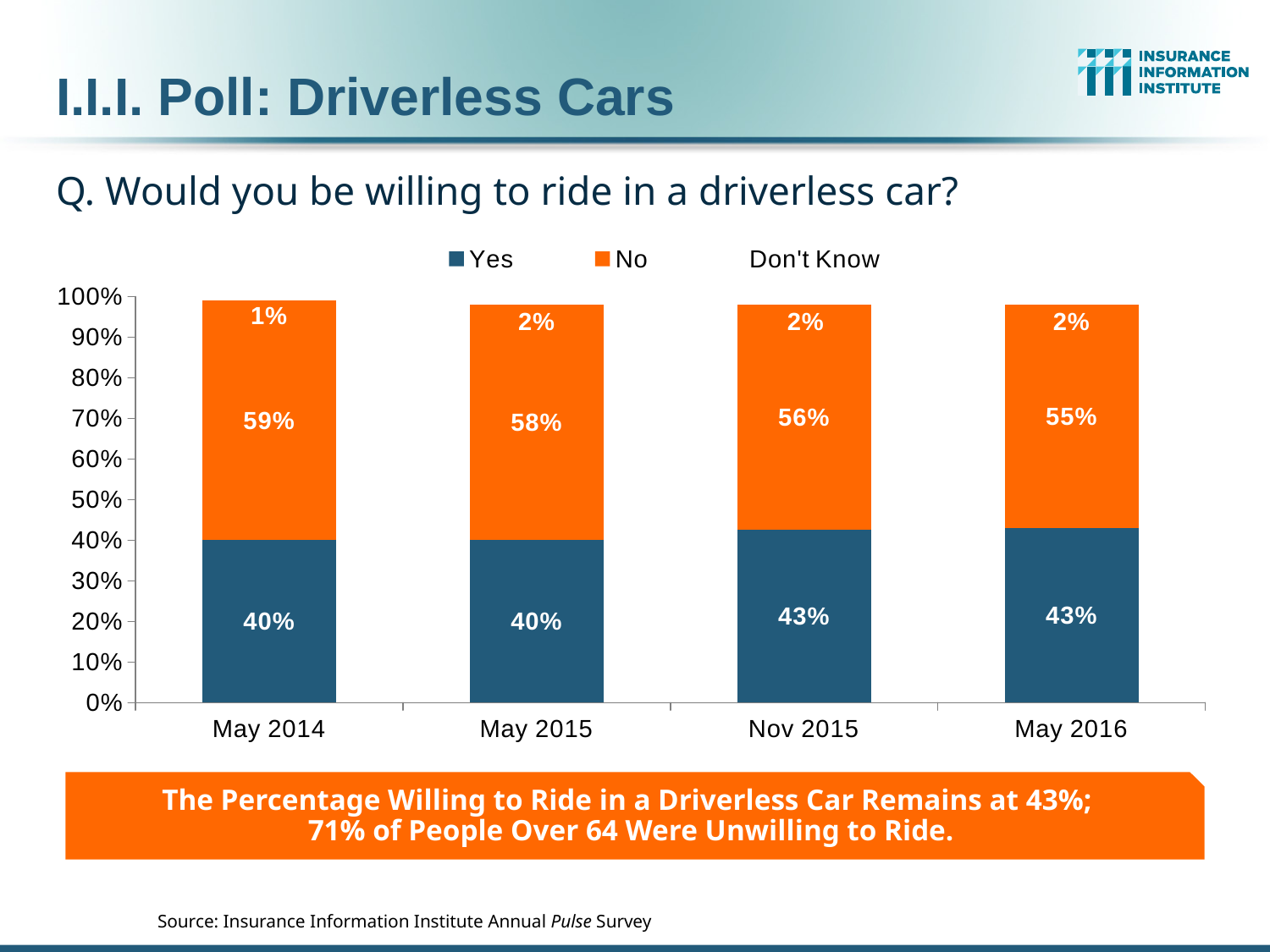
What percentage answered Don't Know in May 2014? 1% In which period was the Don't Know share lowest? May 2014 In which period was the No share highest? May 2014 What percentage answered No in May 2016? 55% What kind of chart is shown on the slide? Stacked bar chart Which is larger: the Yes share in May 2015 or the Yes share in May 2016? May 2016 How many series does the legend list? 3 How many survey periods are shown on the x axis? 4 What percentage answered Yes in May 2014? 40% What percentage answered Yes in Nov 2015? 43% Does the No share rise or fall from May 2014 to May 2016? Fall What is the difference between the No share in May 2014 and the No share in May 2016? 4%